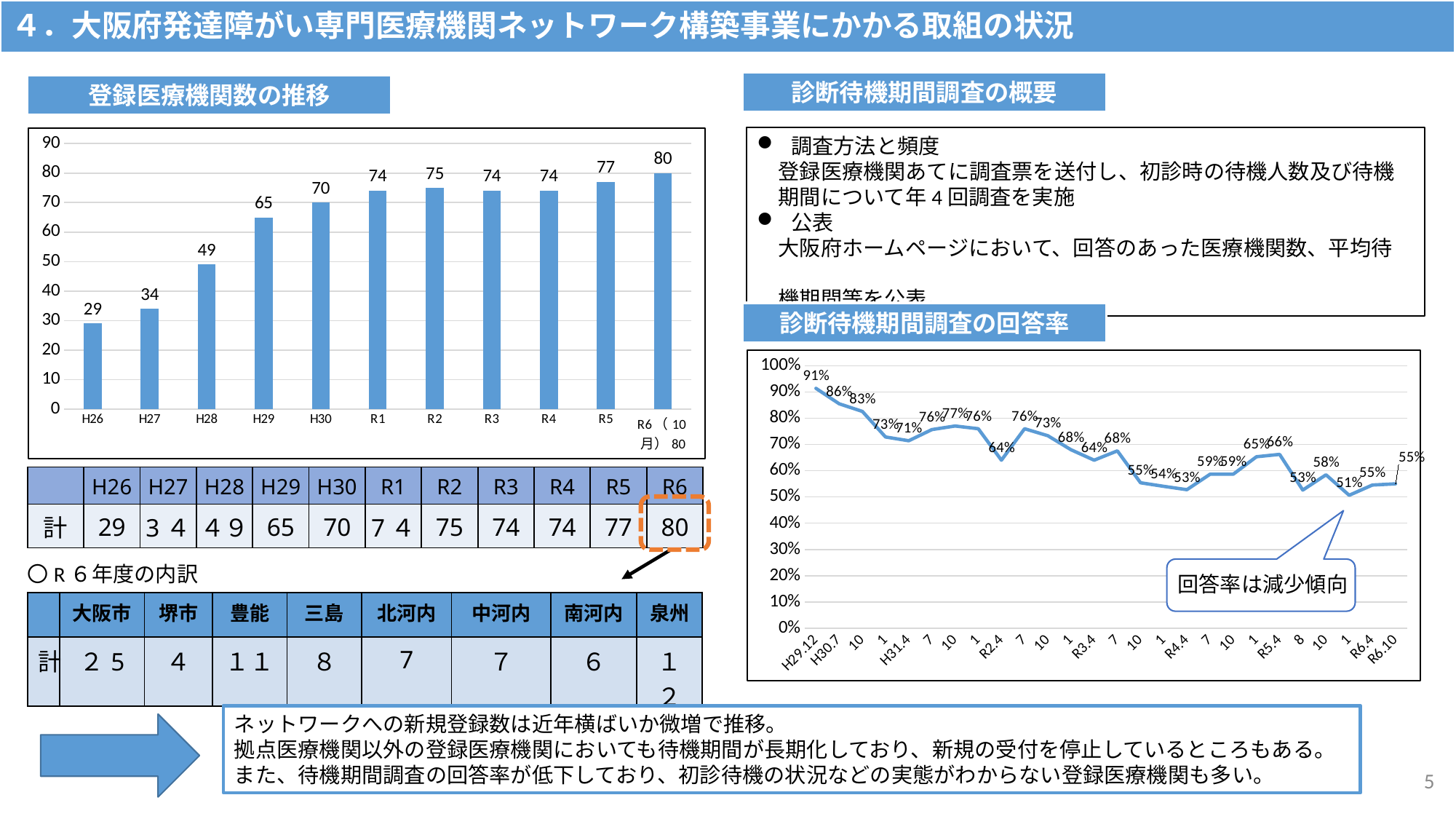
In the bar chart 登録医療機関数の推移, which category has the highest value? R6（10月） In the bar chart 登録医療機関数の推移, what is the value for H29? 65 What kind of chart is 診断待機期間調査の回答率? line chart In the line chart 診断待機期間調査の回答率, what is the value at H29.12? 91% In the line chart 診断待機期間調査の回答率, what is the value at R6.4? 55% In the line chart 診断待機期間調査の回答率, do the values generally rise or fall from left to right? fall In the bar chart 登録医療機関数の推移, which is larger, the value for H30 or the value for R2? R2 How many bars are shown in the bar chart 登録医療機関数の推移? 11 In the bar chart 登録医療機関数の推移, what is the difference between the values for H28 and H27? 15 In the bar chart 登録医療機関数の推移, what is the value for R5? 77 What kind of chart is 登録医療機関数の推移? bar chart In the bar chart 登録医療機関数の推移, which category has the lowest value? H26